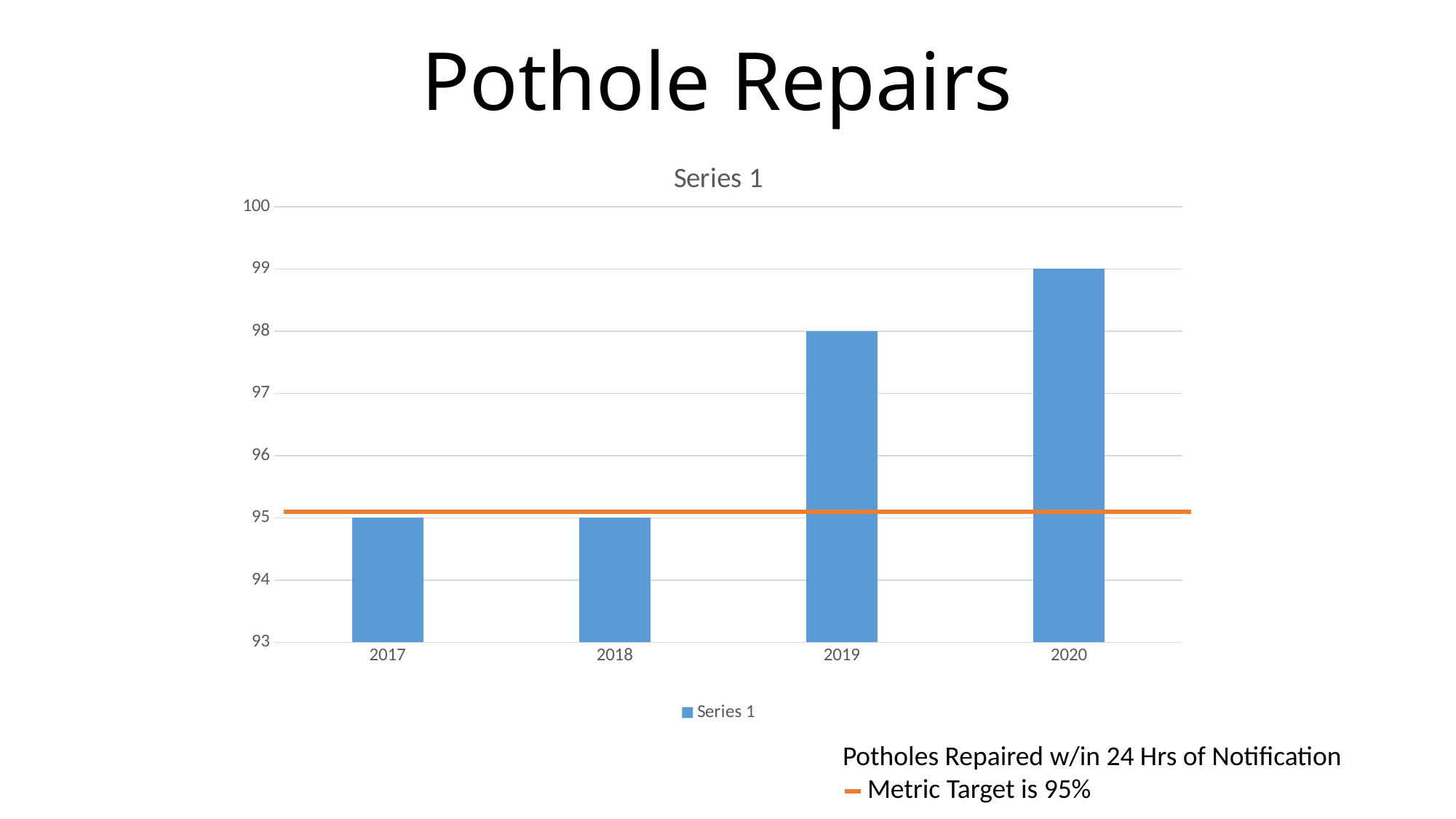
Which year has the highest value? 2020 Do the values rise or fall from 2017 to 2020? rise How many years are shown on the x axis? 4 How many series does the legend list? 1 What is the value for 2017? 95 What metric target does the orange line represent? 95% What is the value for 2019? 98 What is the value for 2020? 99 Is the value for 2019 greater or less than 97? greater What kind of chart is shown on the slide? bar chart Which is larger, the value for 2019 or the value for 2018? 2019 What is the difference between the values for 2020 and 2018? 4